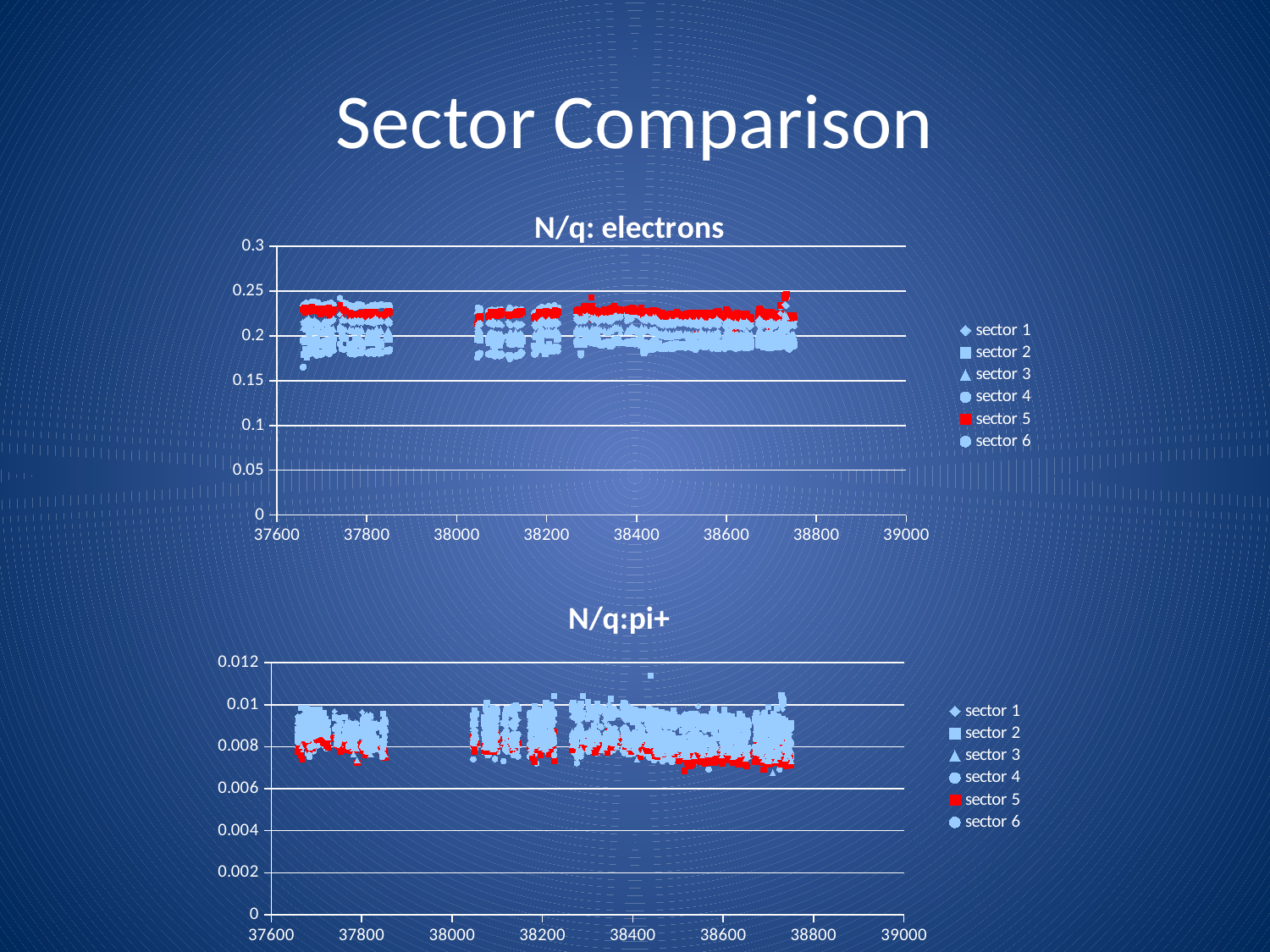
In the "N/q: electrons" chart, are the values for sector 5 greater or less than 0.15? greater How many series does the legend of the "N/q: electrons" chart list? 6 What is the title of the lower chart on the slide? N/q:pi+ What is the maximum value shown on the y axis of the "N/q:pi+" chart? 0.012 In the "N/q: electrons" chart, are the values for sector 5 greater or less than 0.25? less In the "N/q:pi+" chart, which series generally has lower values: sector 5 or sector 2? sector 5 In the "N/q:pi+" chart, are the values for sector 5 greater or less than 0.01? less How many series does the legend of the "N/q:pi+" chart list? 6 In the "N/q: electrons" chart, which series is plotted in red? sector 5 What kind of chart is the "N/q: electrons" chart? scatter chart In the "N/q: electrons" chart, which series generally has higher values: sector 5 or sector 6? sector 5